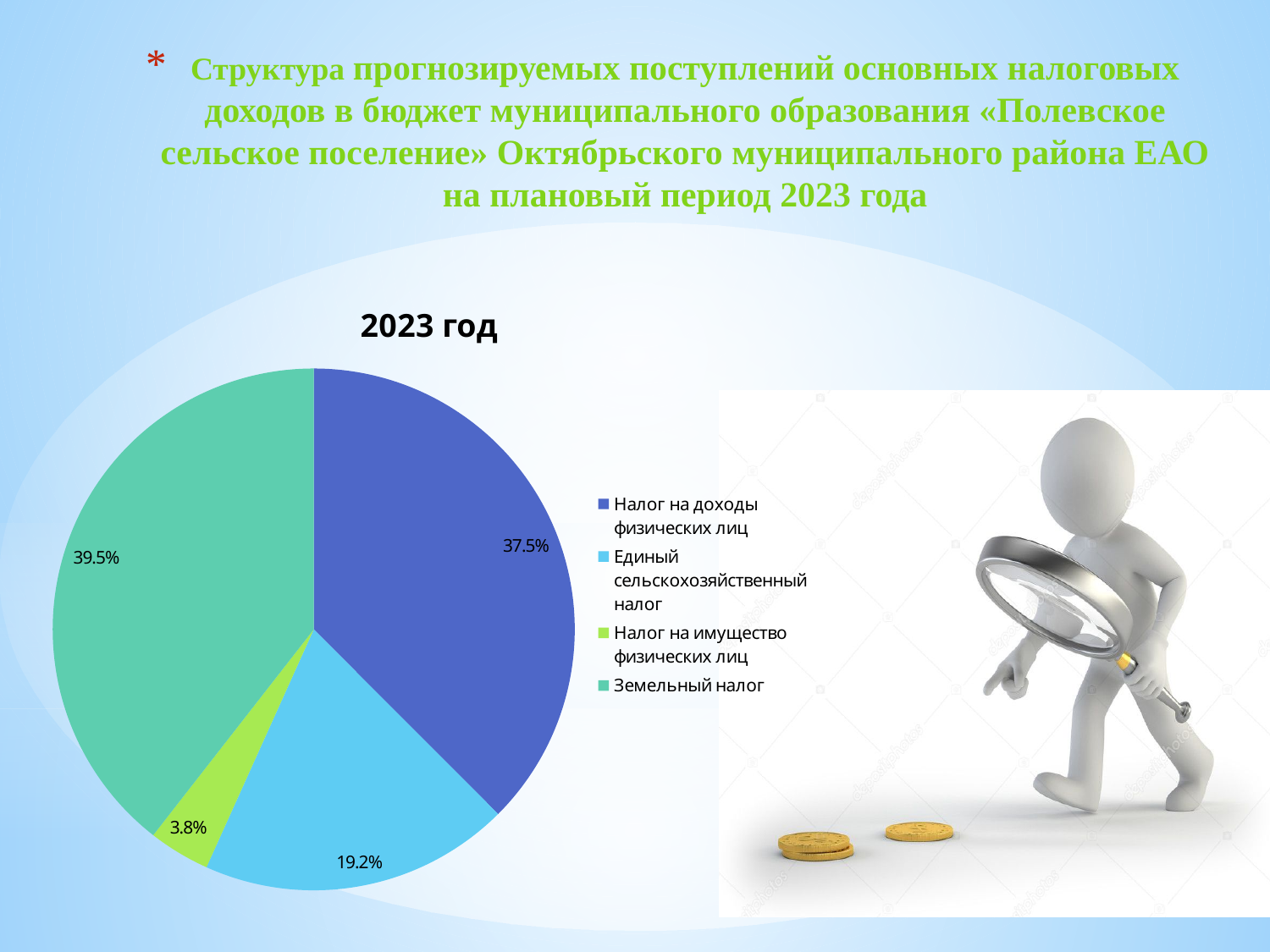
What is the difference in percentage points between Земельный налог and Единый сельскохозяйственный налог? 20.3 How many entries does the legend list? 4 What share of the pie is Налог на доходы физических лиц? 37.5% What share of the pie is Земельный налог? 39.5% What share of the pie is Единый сельскохозяйственный налог? 19.2% How many slices does the pie chart have? 4 What kind of chart is shown on the slide? Pie chart Which category has the largest share of the pie? Земельный налог Which category has the smallest share of the pie? Налог на имущество физических лиц Which is larger: the share for Налог на доходы физических лиц or the share for Единый сельскохозяйственный налог? Налог на доходы физических лиц What is the title of the chart? 2023 год